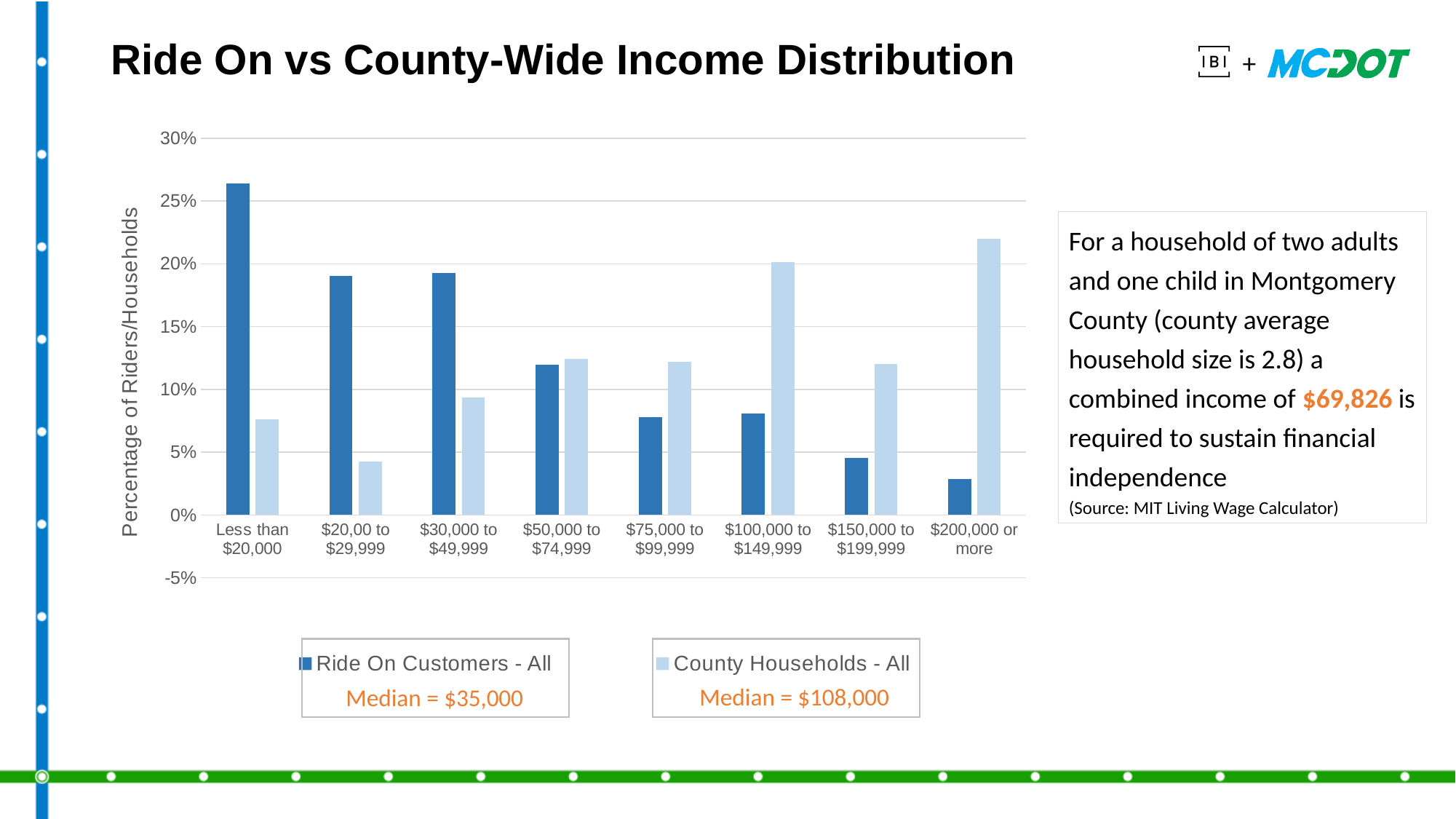
How many series does the legend list? 2 Is the value for Ride On Customers - All in the Less than $20,000 category greater or less than 25%? greater Is the value for County Households - All in the $200,000 or more category greater or less than 20%? greater Is the value for Ride On Customers - All in the $150,000 to $199,999 category greater or less than 5%? less How many income categories are shown on the x axis? 8 In the $200,000 or more category, which series has the larger value: Ride On Customers - All or County Households - All? County Households - All What median income is shown in the legend for Ride On Customers - All? $35,000 What kind of chart is shown on the slide? bar chart In the Less than $20,000 category, which series has the larger value: Ride On Customers - All or County Households - All? Ride On Customers - All Which income category has the highest value for Ride On Customers - All? Less than $20,000 Which income category has the lowest value for Ride On Customers - All? $200,000 or more Which income category has the lowest value for County Households - All? $20,00 to $29,999